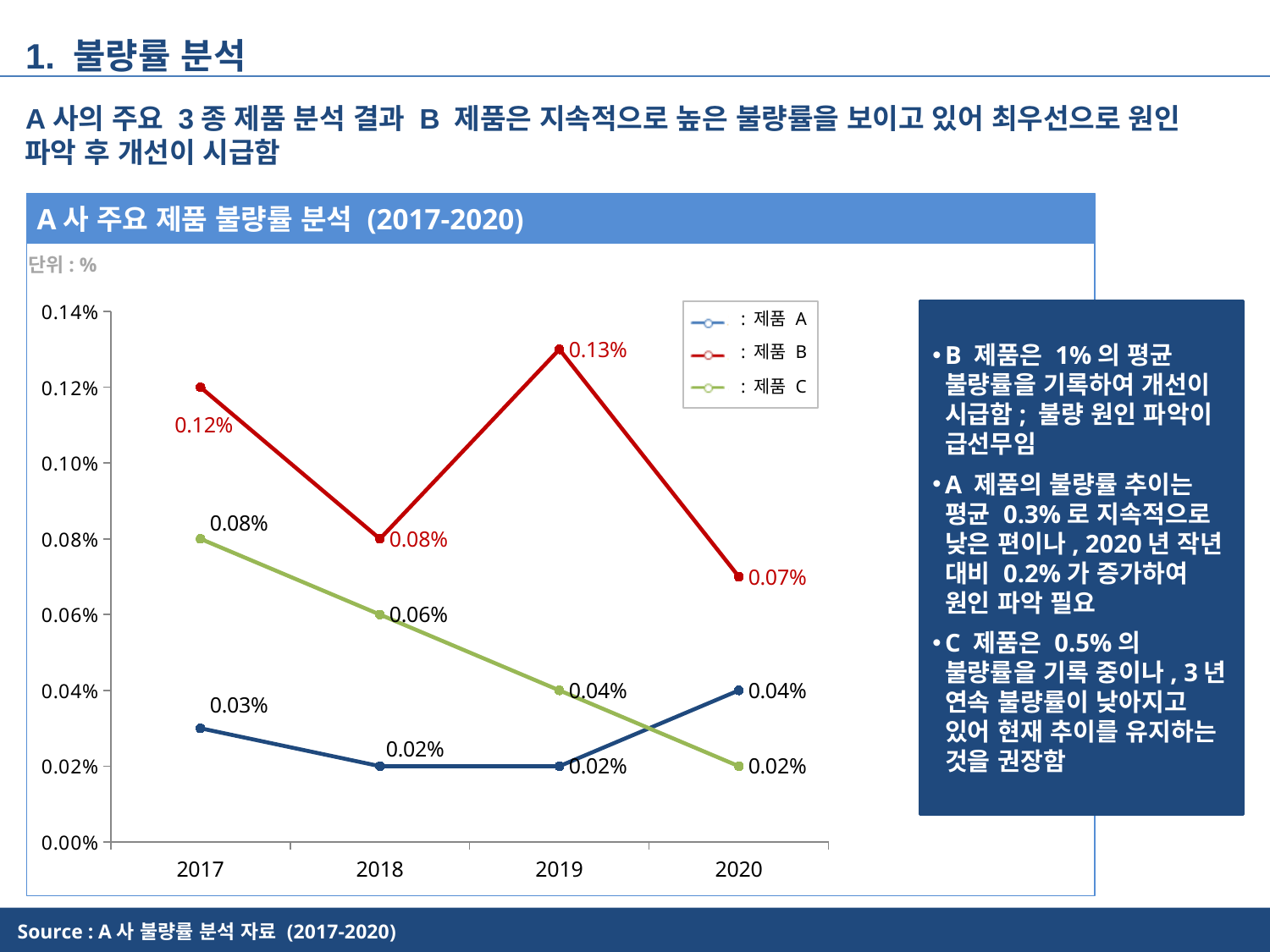
How many series does the legend list? 3 What is the value for 제품 A in 2020? 0.04% What is the title of the chart? A 사 주요 제품 불량률 분석 (2017-2020) What is the value for 제품 B in 2019? 0.13% What is the difference between 제품 B and 제품 A in 2017? 0.09% What type of chart is shown on the slide? line chart How many years are plotted on the x axis? 4 Which is larger in 2020, the value for 제품 A or the value for 제품 C? 제품 A Does the value for 제품 C rise or fall from 2017 to 2020? fall In which year is the value for 제품 B the highest? 2019 In which year is the value for 제품 C the lowest? 2020 What is the value for 제품 C in 2017? 0.08%